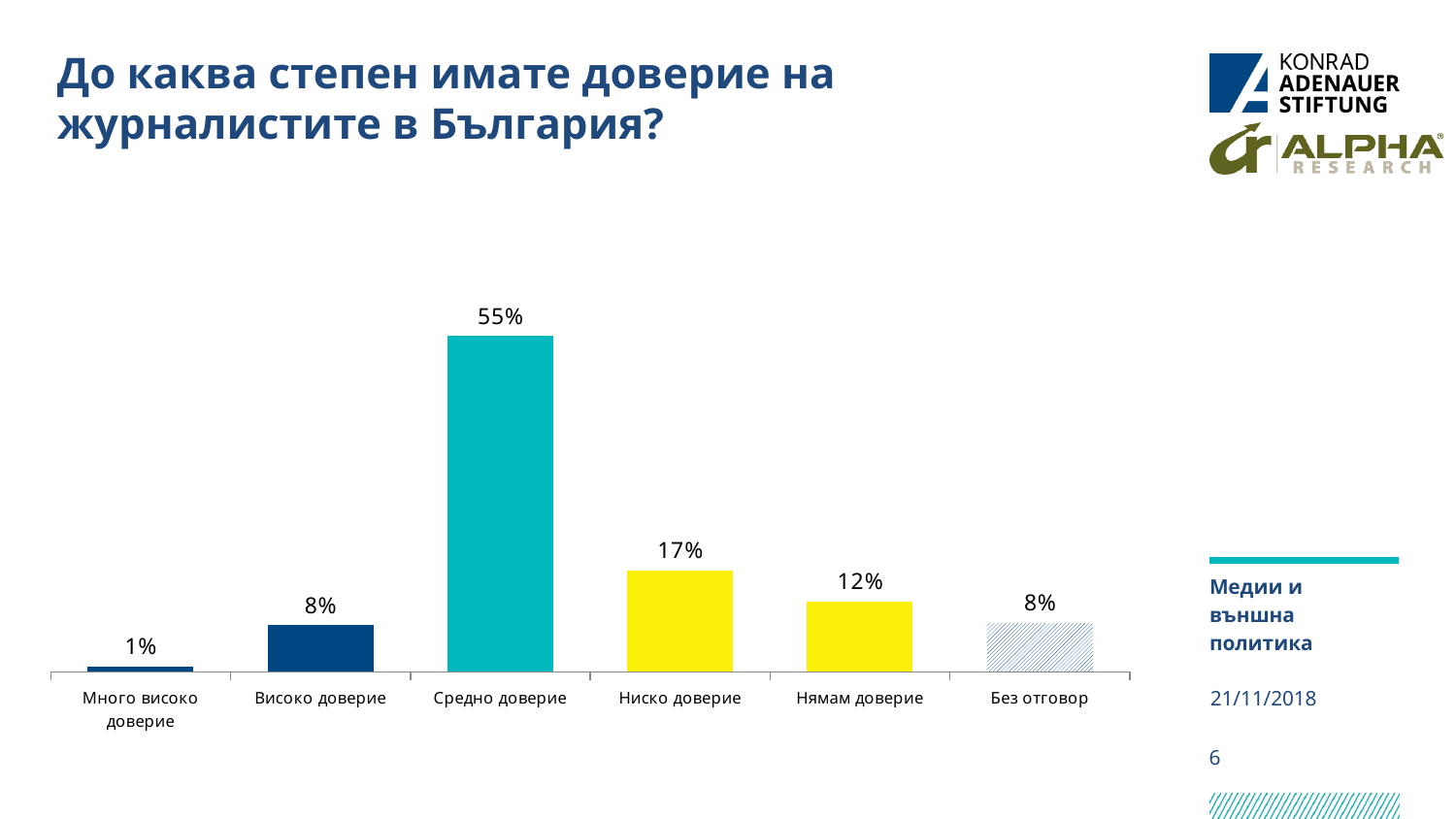
What is the value for "Нямам доверие"? 12% What kind of chart is shown on the slide? Bar chart What is the value for "Средно доверие"? 55% What is the value for "Ниско доверие"? 17% How many categories are shown on the x axis? 6 What is the difference between the values for "Средно доверие" and "Ниско доверие"? 38% Which category has the lowest value? Много високо доверие What is the value for "Много високо доверие"? 1% Which category has the highest value? Средно доверие What is the difference between the values for "Ниско доверие" and "Нямам доверие"? 5% Which is larger, the value for "Високо доверие" or the value for "Нямам доверие"? Нямам доверие Which bar is drawn with a hatched pattern rather than a solid fill? Без отговор